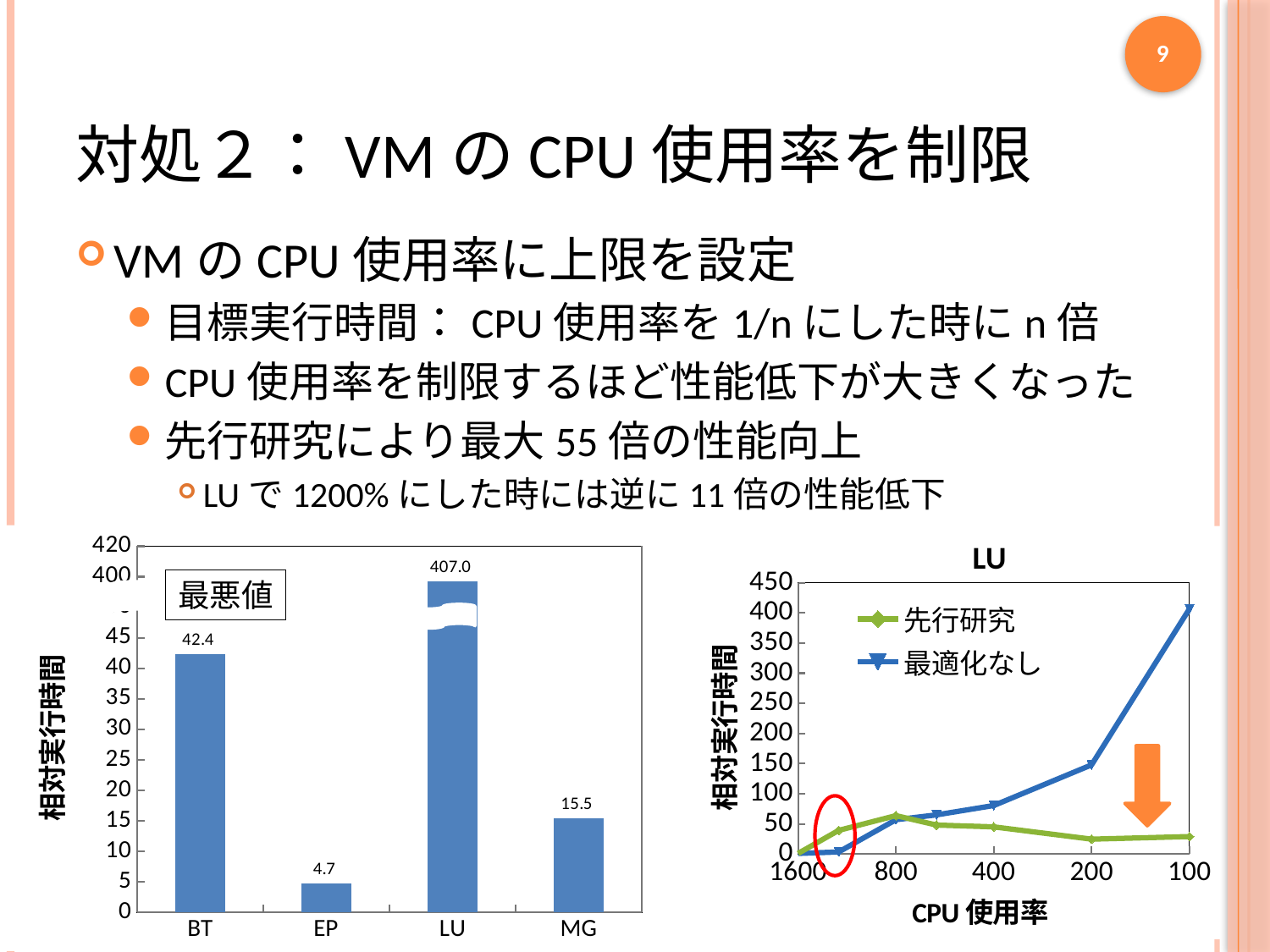
In the left bar chart, what is the value for EP? 4.7 How many categories are shown in the left bar chart? 4 In the right chart titled LU, does the 最適化なし series rise or fall as CPU 使用率 goes from 1600 to 100 along the x axis? rise In the right chart titled LU, is the value of 最適化なし at CPU 使用率 100 greater or less than 350? greater What kind of chart is the left chart on the slide? bar chart In the left bar chart, what is the difference between the values for BT and MG? 26.9 In the left bar chart, what is the value for LU? 407.0 In the left bar chart, what is the value for MG? 15.5 How many series does the legend of the right chart titled LU list? 2 In the left bar chart, which category has the highest value? LU In the left bar chart, which is larger, the value for BT or the value for MG? BT In the left bar chart, which category has the lowest value? EP